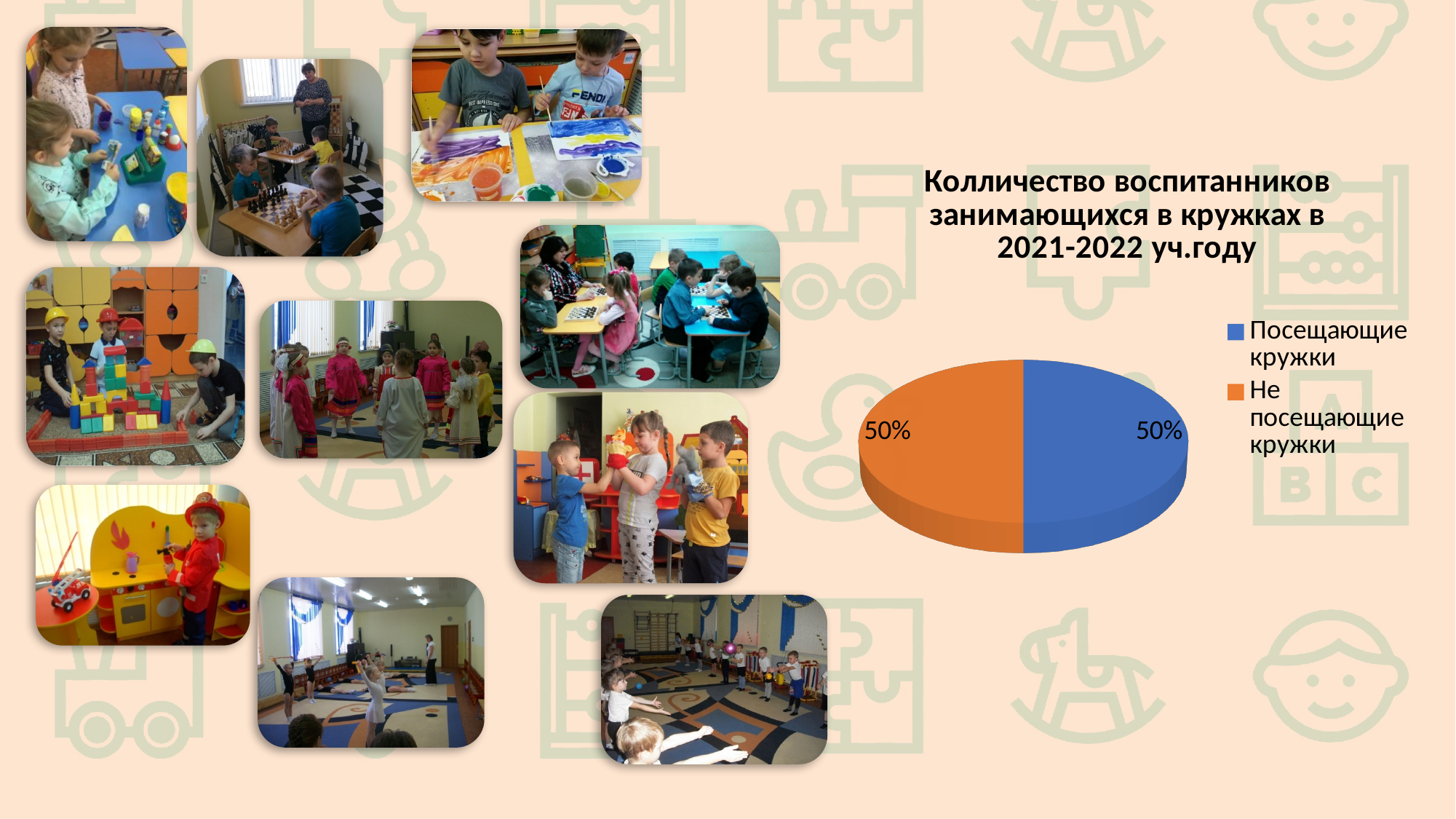
What share of the pie chart is labelled "Не посещающие кружки"? 50% What is the difference between the share for "Посещающие кружки" and the share for "Не посещающие кружки"? 0% What kind of chart is shown on the slide? Pie chart Which colour represents "Не посещающие кружки" in the pie chart? Orange What is the title of the chart? Колличество воспитанников занимающихся в кружках в 2021-2022 уч.году How many slices does the pie chart have? 2 Is the share for "Посещающие кружки" larger than, smaller than, or equal to the share for "Не посещающие кружки"? Equal What share of the pie chart is labelled "Посещающие кружки"? 50% What is the combined share of the two slices in the pie chart? 100% How many entries does the chart legend list? 2